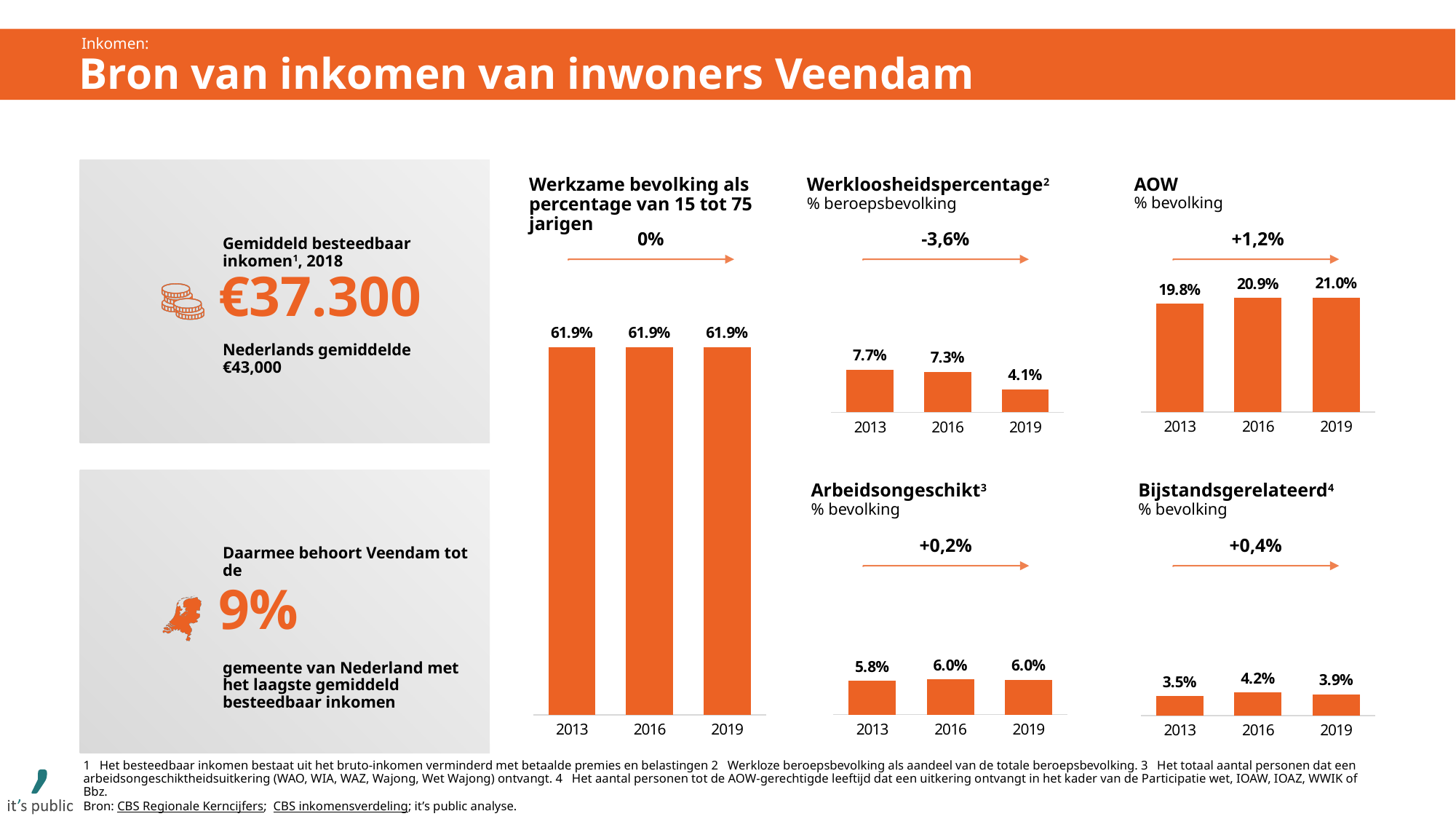
In the 'Bijstandsgerelateerd' chart, which is larger, the value for 2016 or the value for 2019? 2016 In the 'AOW' chart, what is the value for 2013? 19.8% In the 'Werkloosheidspercentage' chart, what is the difference between the 2013 and 2019 values? 3.6% In the 'Werkzame bevolking als percentage van 15 tot 75 jarigen' chart, what is the value for 2016? 61.9% In the 'Bijstandsgerelateerd' chart, what is the value for 2016? 4.2% In the 'Werkloosheidspercentage' chart, what is the value for 2019? 4.1% In the 'Werkloosheidspercentage' chart, do the values rise or fall from 2013 to 2019? fall How many years are shown on the x axis of the 'AOW' chart? 3 In the 'Arbeidsongeschikt' chart, what is the value for 2013? 5.8% In the 'Werkloosheidspercentage' chart, which year has the highest value? 2013 In the 'AOW' chart, what is the difference between the 2019 and 2013 values? 1.2% In the 'Bijstandsgerelateerd' chart, which year has the lowest value? 2013